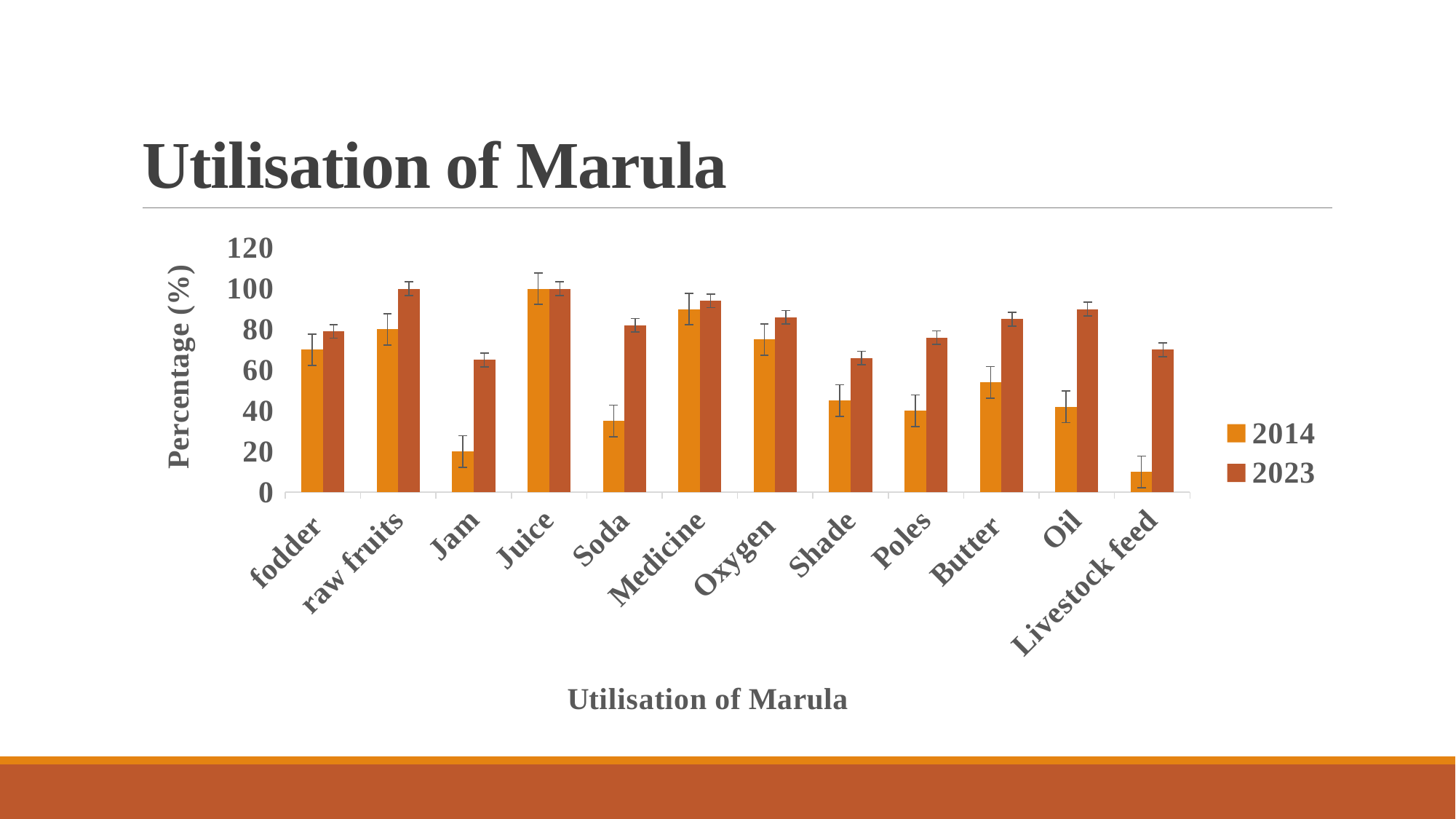
What type of chart is shown on the slide? bar chart Which category has the highest 2014 value? Juice Is the 2014 value for Soda greater or less than 40? less Is the 2023 value for Livestock feed greater or less than 60? greater What is the label on the y axis? Percentage (%) What is the 2014 value for Juice? 100 How many series does the legend list? 2 What is the 2014 value for Jam? 20 What is the 2023 value for raw fruits? 100 For Oil, which series has the larger value, 2014 or 2023? 2023 Which category has the lowest 2014 value? Livestock feed How many categories are shown on the x axis? 12